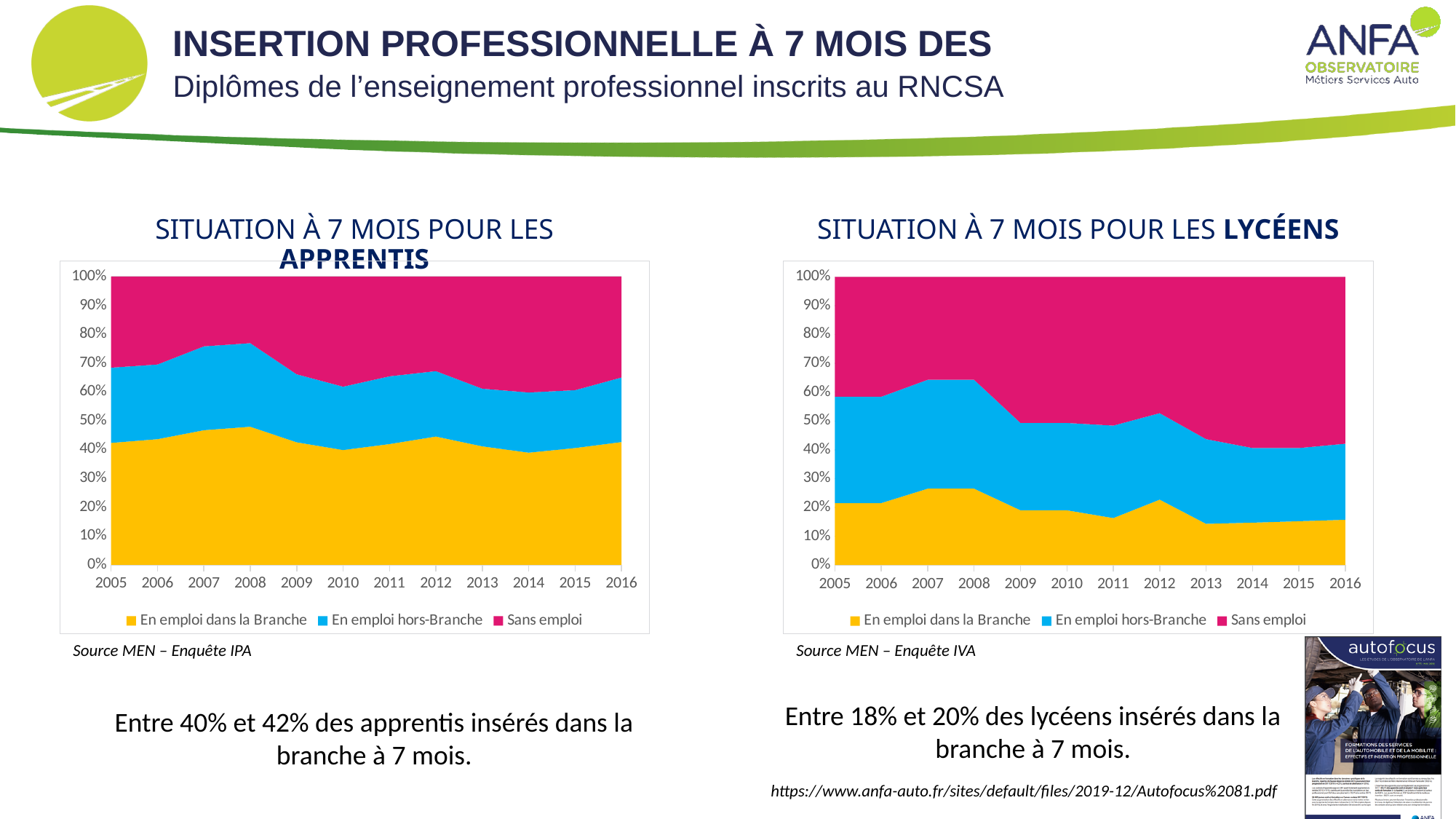
In the 'Situation à 7 mois pour les lycéens' chart, is the combined share of the two 'En emploi' series in 2016 greater or less than 50%? less In the 'Situation à 7 mois pour les apprentis' chart, which year has the larger 'En emploi dans la Branche' share, 2008 or 2010? 2008 How many years are shown on the x axis of the 'Situation à 7 mois pour les apprentis' chart? 12 In the 'Situation à 7 mois pour les lycéens' chart, is the value for 'En emploi dans la Branche' in 2013 greater or less than 20%? less In the 'Situation à 7 mois pour les apprentis' chart, is the value for 'En emploi dans la Branche' in 2010 greater or less than 50%? less In the 'Situation à 7 mois pour les lycéens' chart, does the 'En emploi dans la Branche' share rise or fall from 2008 to 2013? fall What kind of chart is the 'Situation à 7 mois pour les apprentis' chart on the left? Stacked area chart Which colour represents 'Sans emploi' in the 'Situation à 7 mois pour les apprentis' chart? Pink/magenta How many series does the legend of the 'Situation à 7 mois pour les lycéens' chart list? 3 In the 'Situation à 7 mois pour les lycéens' chart, which year has the larger 'En emploi dans la Branche' share, 2008 or 2013? 2008